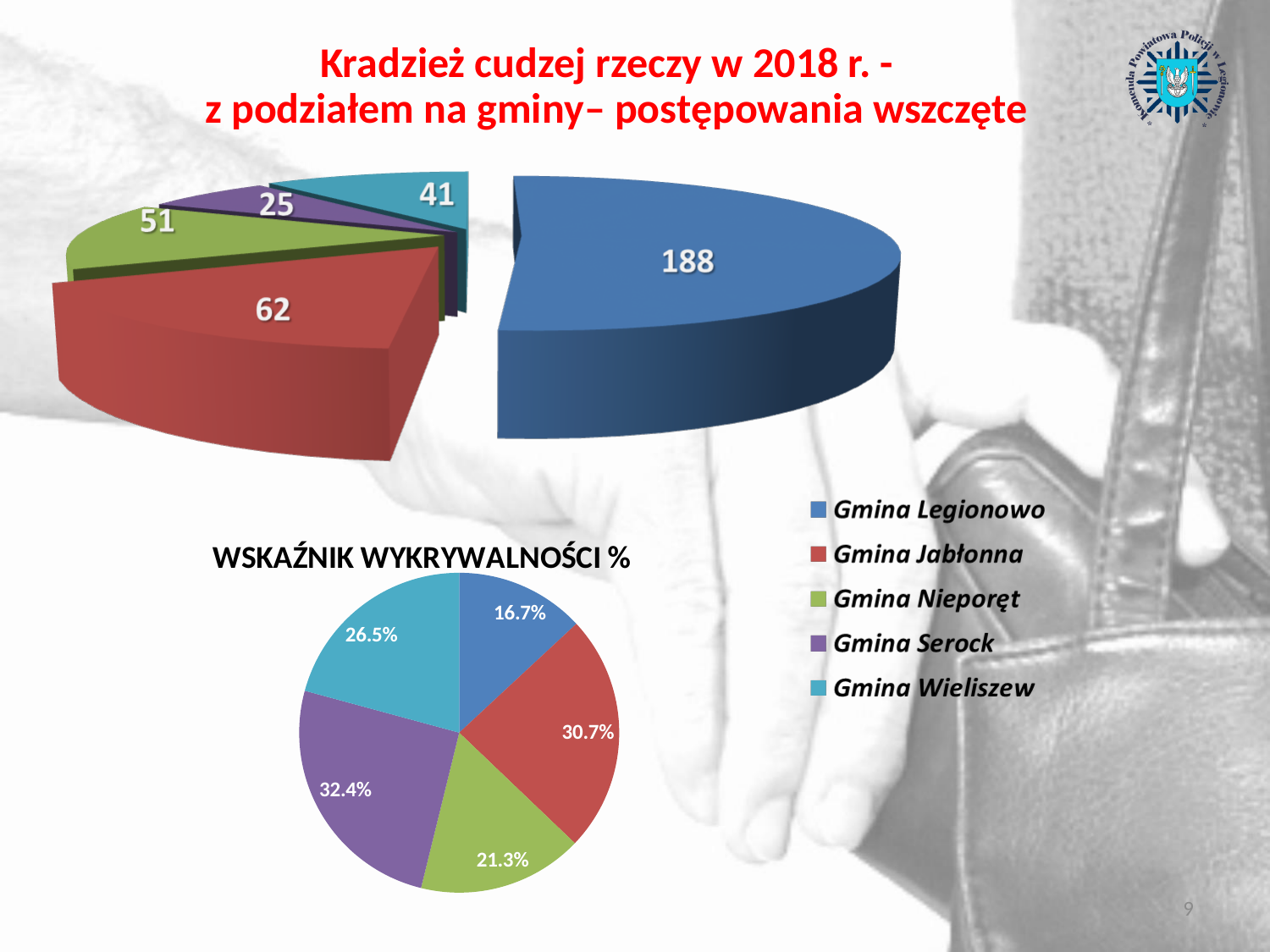
How many slices does the chart titled WSKAŹNIK WYKRYWALNOŚCI % have? 5 In the chart titled WSKAŹNIK WYKRYWALNOŚCI %, which gmina has the highest value? Gmina Serock In the chart titled WSKAŹNIK WYKRYWALNOŚCI %, what is the value for Gmina Legionowo? 16.7% In the top pie chart, which is larger: the value for Gmina Nieporęt or Gmina Wieliszew? Gmina Nieporęt In the top pie chart, what is the value for Gmina Jabłonna? 62 What kind of chart is the top chart on the slide? Pie chart In the top pie chart, which gmina has the highest value? Gmina Legionowo In the top pie chart, what is the value for Gmina Wieliszew? 41 In the chart titled WSKAŹNIK WYKRYWALNOŚCI %, what is the value for Gmina Serock? 32.4% In the top pie chart, which gmina has the lowest value? Gmina Serock In the top pie chart, what is the value for Gmina Legionowo? 188 In the top pie chart, what is the difference between the values for Gmina Legionowo and Gmina Jabłonna? 126